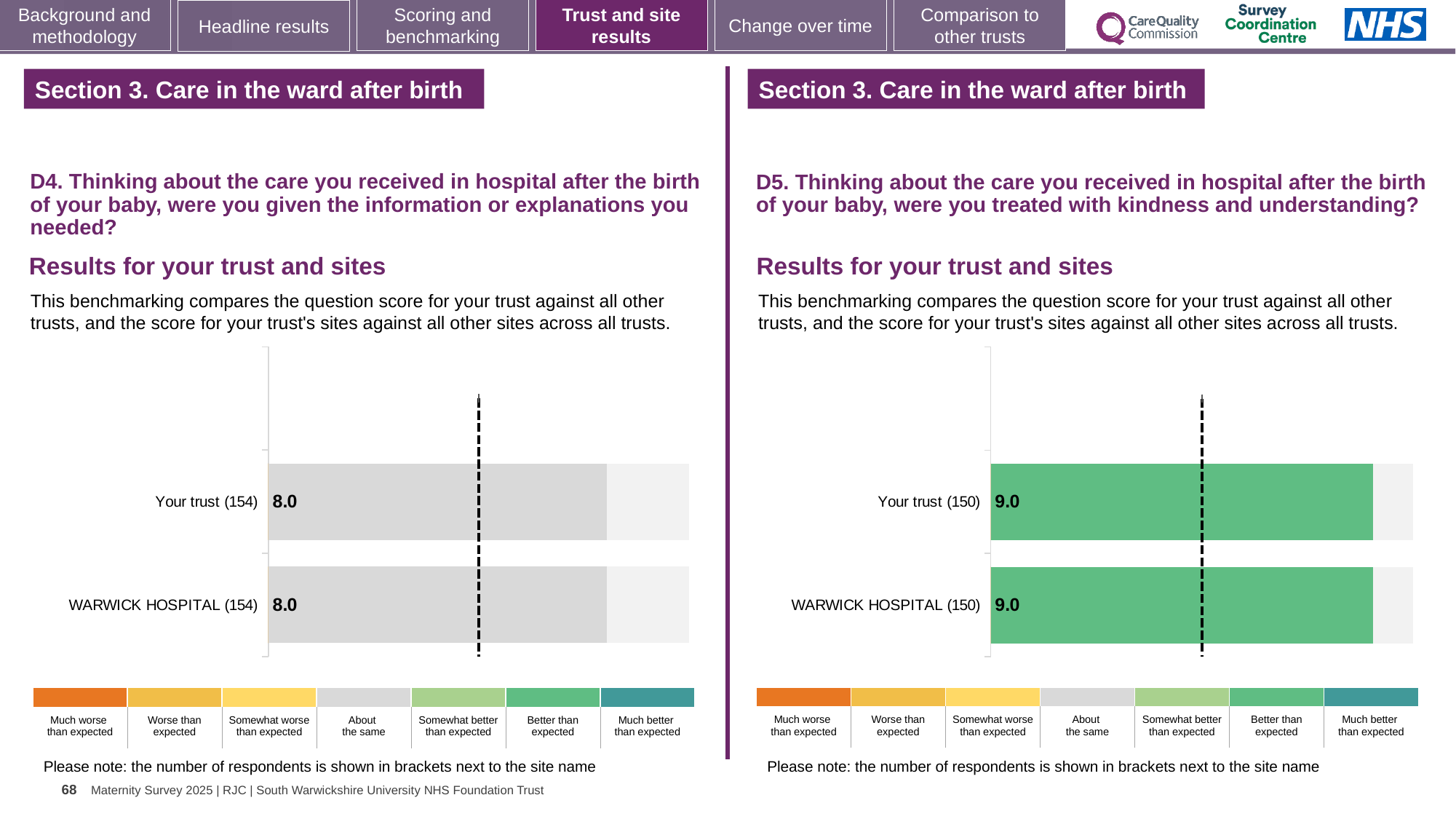
On the D4 chart (left), what is the score for Your trust? 8.0 On the D4 chart (left), what is the score for WARWICK HOSPITAL? 8.0 On the D4 chart (left), which benchmark category does the colour of the bars correspond to according to the key? About the same On the D4 chart (left), what is the difference between the score for Your trust and the score for WARWICK HOSPITAL? 0.0 How many bars are plotted on the D4 chart (left)? 2 Is the score for Your trust on the D5 chart (right) larger or smaller than the score for Your trust on the D4 chart (left)? larger On the D4 chart (left), how many respondents are shown in brackets next to Your trust? 154 On the D5 chart (right), what is the score for WARWICK HOSPITAL? 9.0 On the D5 chart (right), what is the score for Your trust? 9.0 How many bars are plotted on the D5 chart (right)? 2 On the D5 chart (right), which benchmark category does the colour of the bars correspond to according to the key? Better than expected What kind of chart is the D5 chart (right)? bar chart